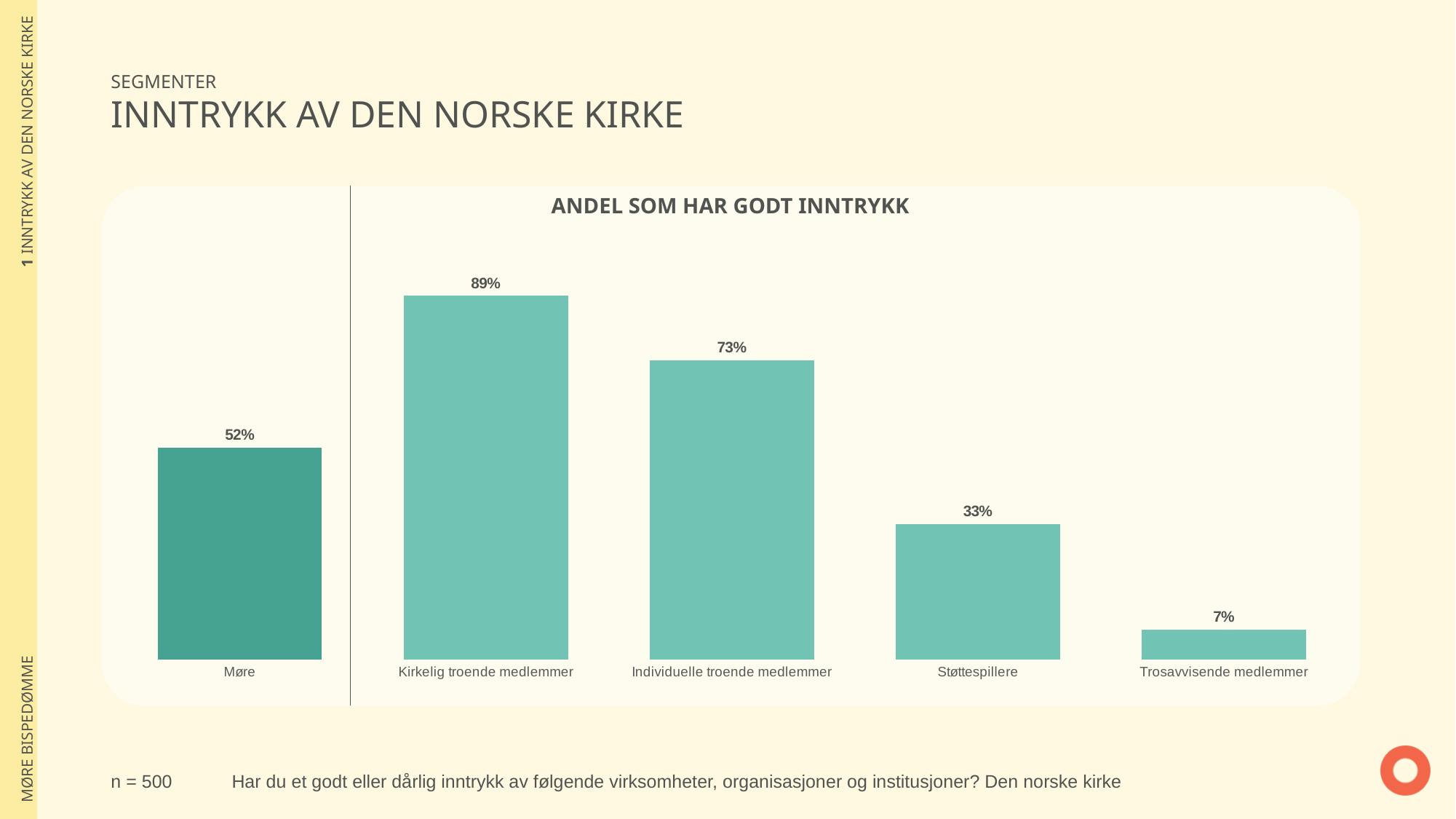
What is the value for Møre? 52% Which category has the lowest value? Trosavvisende medlemmer What is the difference between the values for Møre and Støttespillere? 19% How many categories are shown in the chart? 5 Which is larger, the value for Individuelle troende medlemmer or the value for Møre? Individuelle troende medlemmer What is the title of the chart? ANDEL SOM HAR GODT INNTRYKK Which category has the highest value? Kirkelig troende medlemmer What is the value for Trosavvisende medlemmer? 7% What is the value for Støttespillere? 33% What is the value for Kirkelig troende medlemmer? 89% What kind of chart is shown on the slide? Bar chart What is the difference between the values for Kirkelig troende medlemmer and Individuelle troende medlemmer? 16%